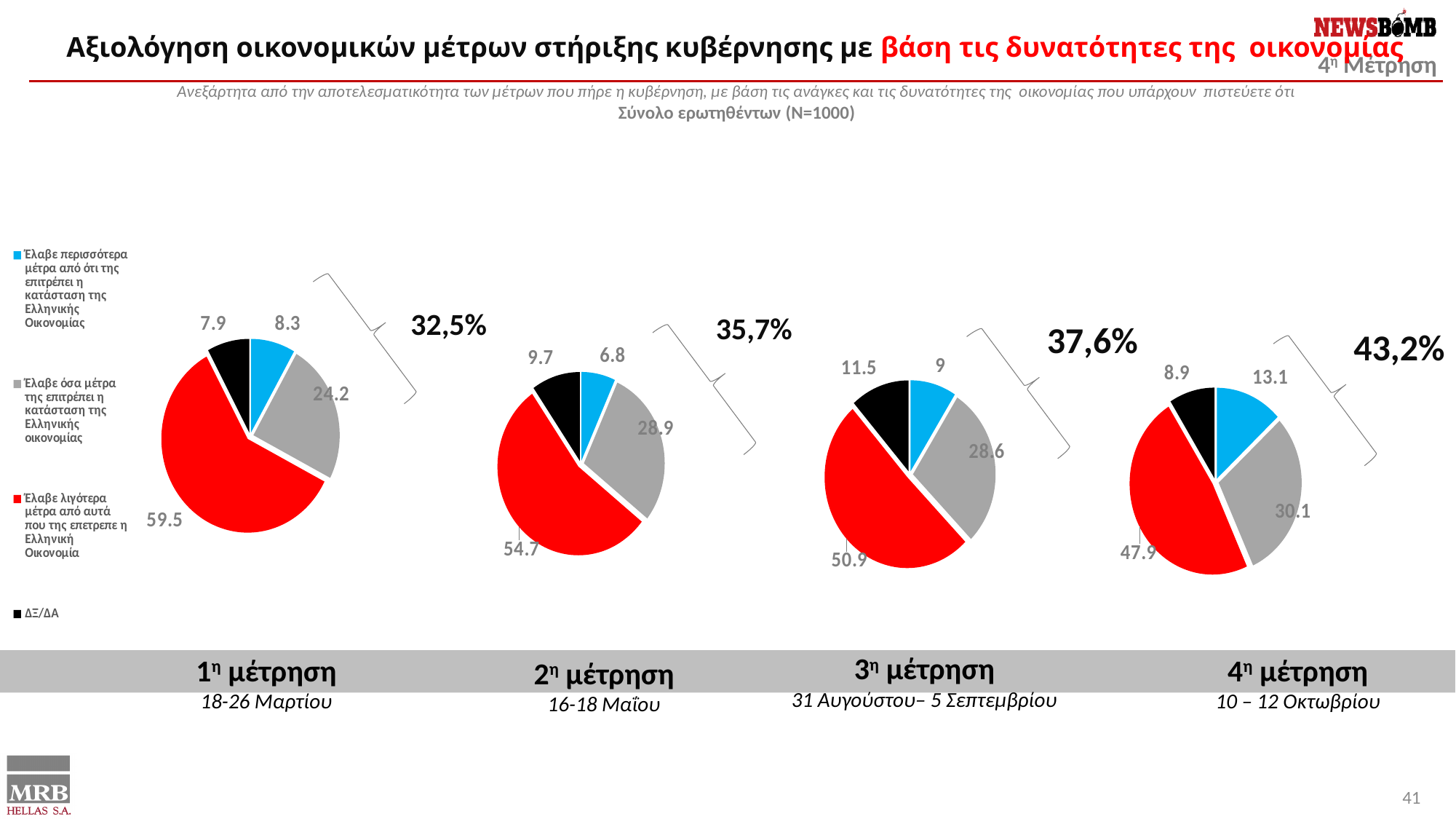
What is the difference between the 'Έλαβε λιγότερα μέτρα' value in the 1η μέτρηση chart and in the 4η μέτρηση chart? 11.6 What combined percentage is shown by the bracket next to the 3η μέτρηση pie chart? 37,6% In the 4η μέτρηση pie chart, what is the value for 'Έλαβε περισσότερα μέτρα από ότι της επιτρέπει η κατάσταση της Ελληνικής Οικονομίας'? 13.1 In the 3η μέτρηση pie chart, which category has the largest slice? Έλαβε λιγότερα μέτρα από αυτά που της επέτρεπε η Ελληνική Οικονομία In the 4η μέτρηση pie chart, which is larger: the grey slice ('Έλαβε όσα μέτρα') or the blue slice ('Έλαβε περισσότερα μέτρα')? Έλαβε όσα μέτρα της επιτρέπει η κατάσταση της Ελληνικής οικονομίας In the 3η μέτρηση pie chart, what is the value for ΔΞ/ΔΑ? 11.5 How many slices does each pie chart on the slide have? 4 In the 2η μέτρηση pie chart, which category has the smallest slice? Έλαβε περισσότερα μέτρα από ότι της επιτρέπει η κατάσταση της Ελληνικής Οικονομίας In the 1η μέτρηση pie chart, what is the value for 'Έλαβε λιγότερα μέτρα από αυτά που της επέτρεπε η Ελληνική Οικονομία'? 59.5 What type of charts are shown on the slide? Pie charts In the 2η μέτρηση pie chart, what is the value for 'Έλαβε όσα μέτρα της επιτρέπει η κατάσταση της Ελληνικής οικονομίας'? 28.9 Across the four measurements from 1η to 4η μέτρηση, does the 'Έλαβε λιγότερα μέτρα' value rise or fall? Fall